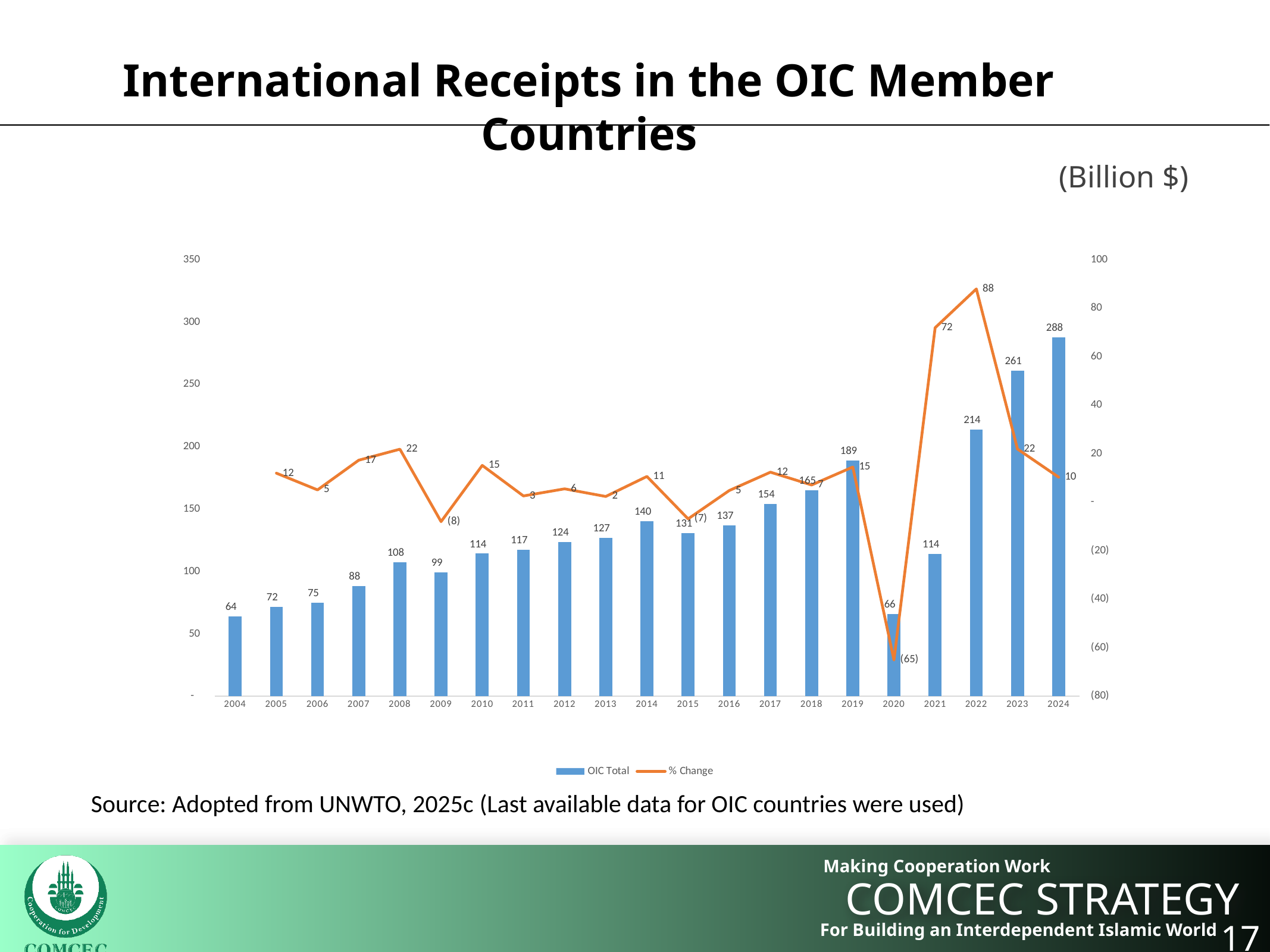
What is the % Change value for 2020? (65) What is the % Change value for 2022? 88 How many series does the legend list? 2 Which is larger, the OIC Total for 2019 or for 2021? 2019 What is the OIC Total value for 2020? 66 What is the OIC Total value for 2024? 288 What are the two series named in the legend? OIC Total and % Change Which year has the highest OIC Total? 2024 What is the difference between the OIC Total for 2024 and 2023? 27 How many years are shown on the x axis? 21 What kind of chart is used for the OIC Total series? Bar chart Which year has the lowest OIC Total? 2004